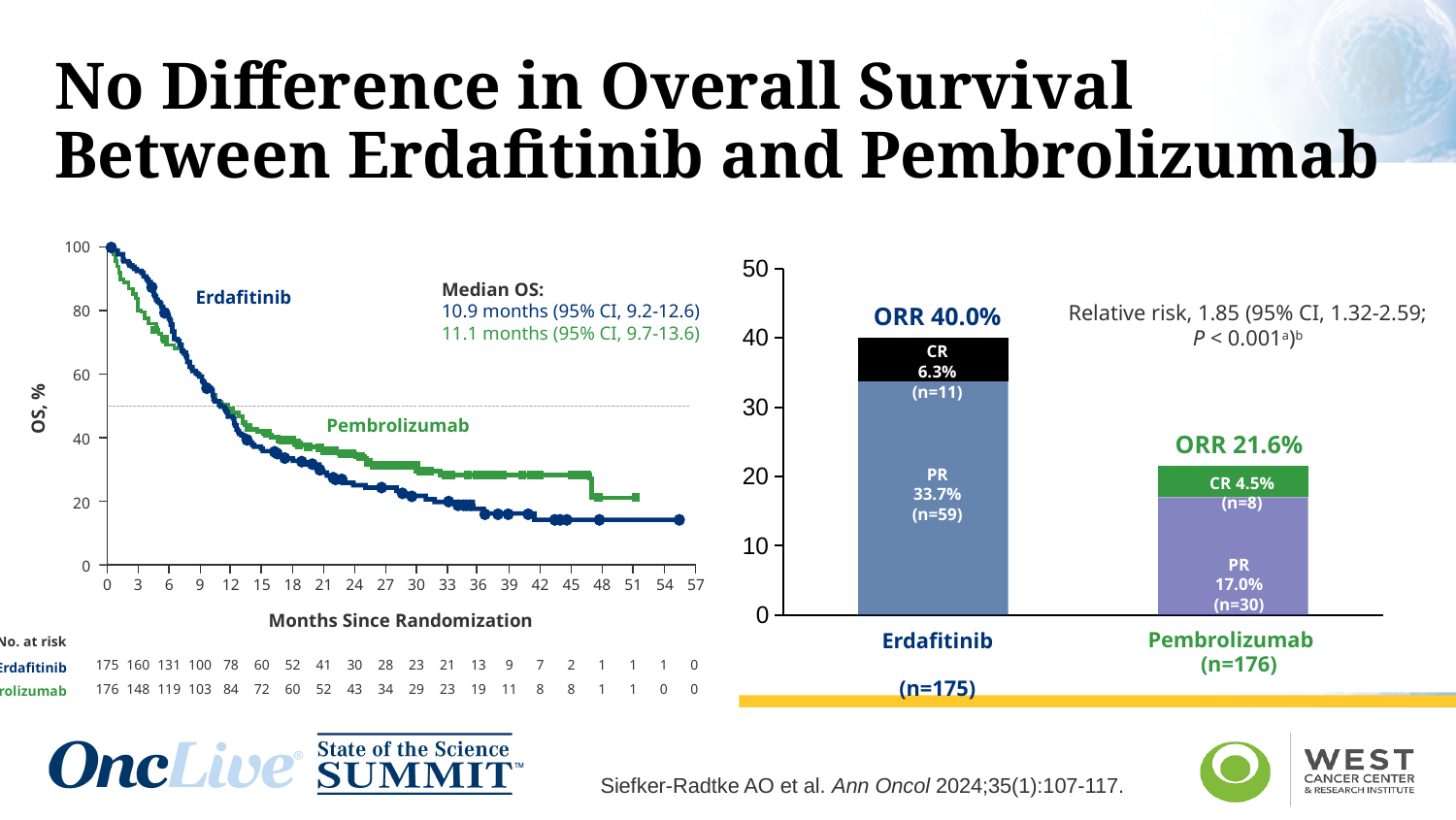
In the bar chart on the right, what is the PR rate for Erdafitinib? 33.7% In the survival chart on the left, what is the median OS for Pembrolizumab? 11.1 months In the survival chart on the left, do the OS curves rise or fall as months since randomization increase? Fall In the bar chart on the right, how many treatment arms are shown as bars? 2 In the bar chart on the right, which arm has the higher ORR, Erdafitinib or Pembrolizumab? Erdafitinib In the bar chart on the right, how many patients had a PR in the Pembrolizumab arm? n=30 In the bar chart on the right, what is the ORR for Erdafitinib? 40.0% What kind of chart is shown on the right side of the slide? Stacked bar chart In the survival chart on the left, what is the median OS for Erdafitinib? 10.9 months In the bar chart on the right, what is the difference in ORR between Erdafitinib and Pembrolizumab? 18.4 percentage points In the bar chart on the right, what is the CR rate for Pembrolizumab? 4.5% In the bar chart on the right, what is the total of the Erdafitinib stacked bar (CR plus PR)? 40.0%